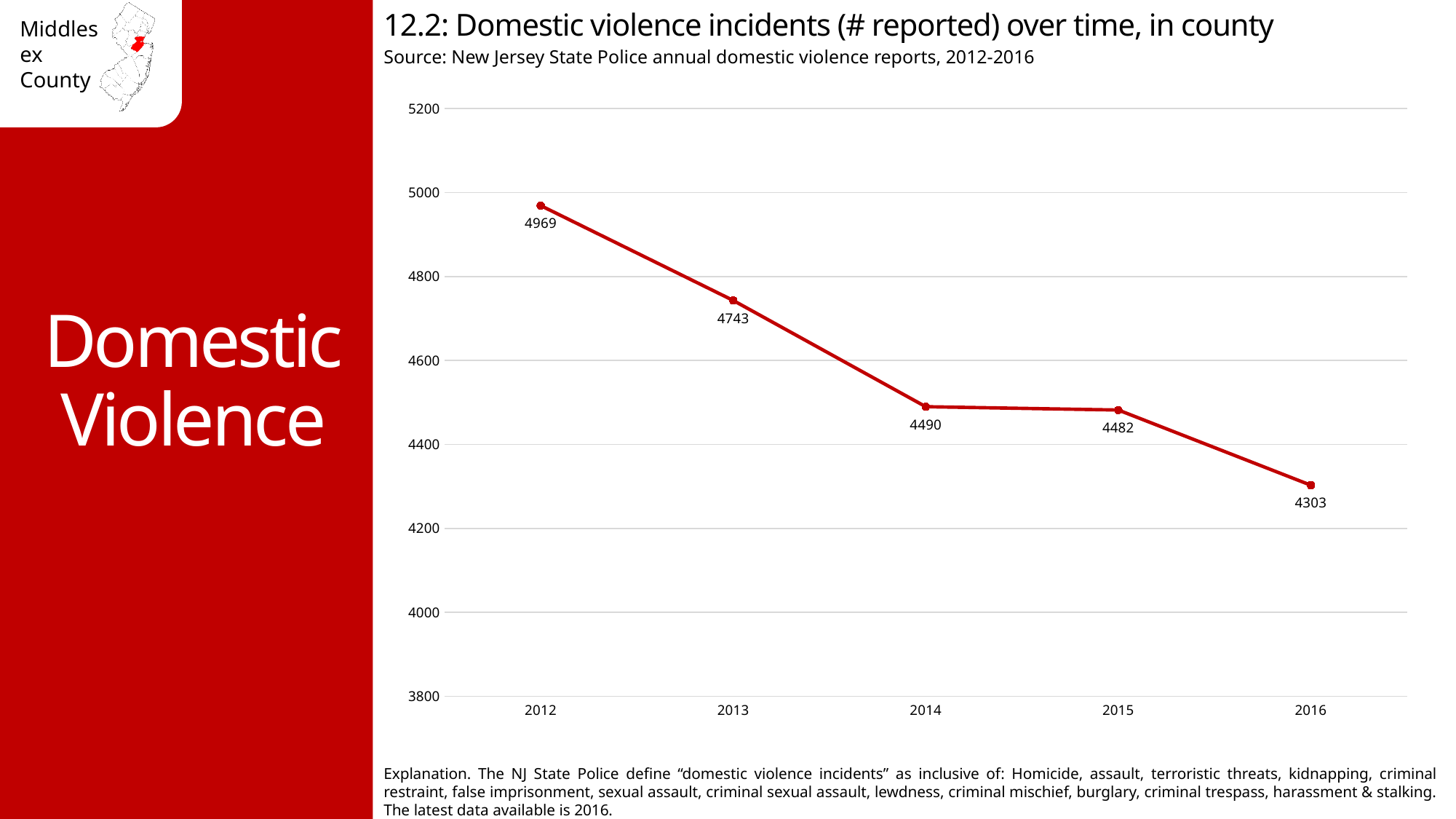
By how much did the number of reported incidents fall from 2012 to 2016? 666 Which year had the highest number of reported domestic violence incidents? 2012 Is the value for 2015 greater or less than 4600? less How many years are plotted on the chart? 5 What was the number of reported domestic violence incidents in 2014? 4490 What is the difference between the 2013 and 2014 values? 253 Do the values rise or fall from 2012 to 2016? fall What was the number of reported domestic violence incidents in 2016? 4303 What was the number of reported domestic violence incidents in 2012? 4969 What kind of chart is shown on the slide? line chart Which year had the lowest number of reported domestic violence incidents? 2016 Which year had more reported incidents, 2013 or 2015? 2013